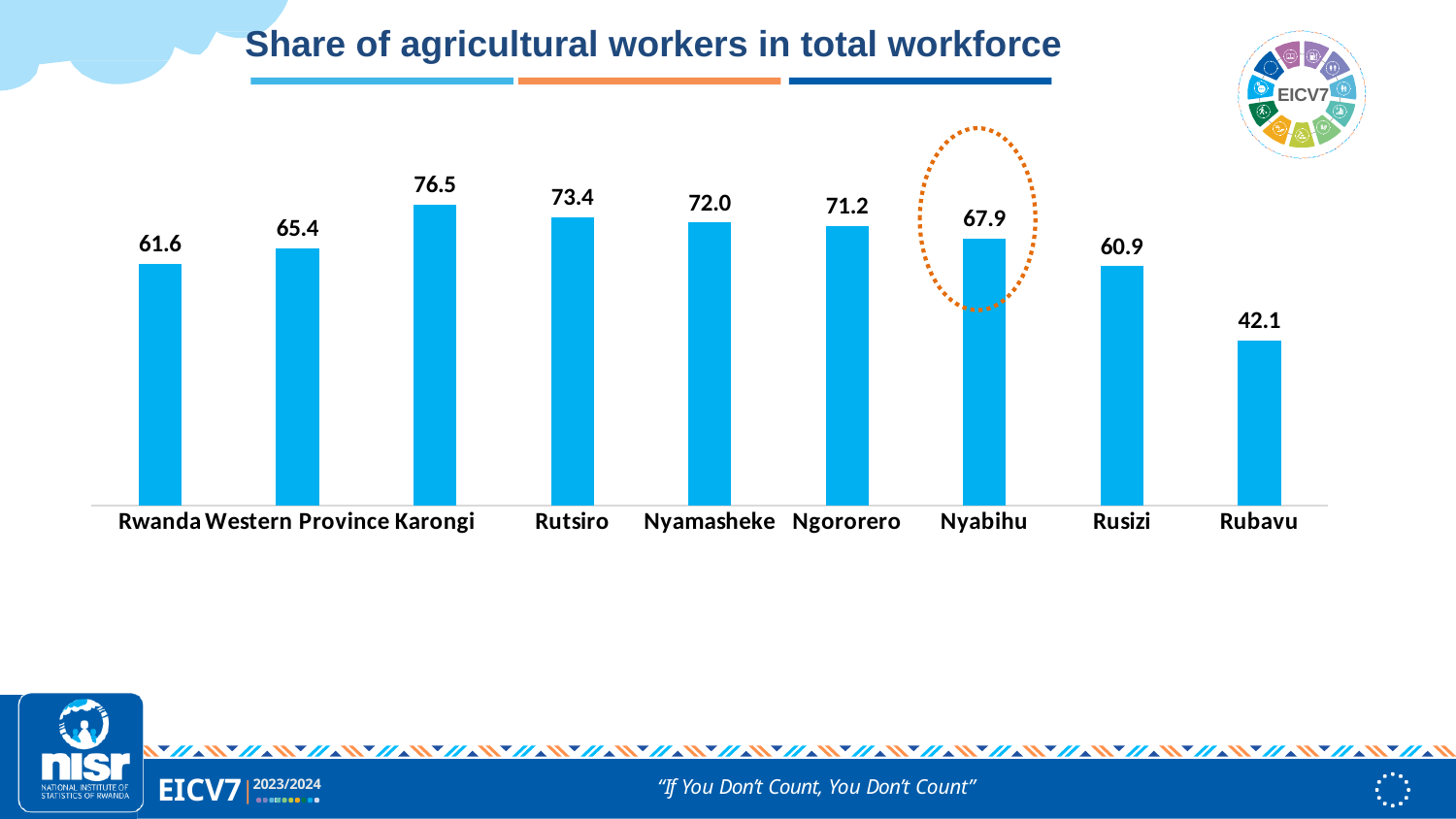
What is the difference between the values for Karongi and Rubavu? 34.4 Which category has the highest share of agricultural workers? Karongi Which bar is highlighted with a dotted orange circle? Nyabihu What is the value shown for Rwanda? 61.6 How many categories are shown on the chart? 9 What is the value shown for Nyabihu? 67.9 Which category has the lowest share of agricultural workers? Rubavu What kind of chart is shown on the slide? Bar chart What is the difference between the values for Western Province and Rwanda? 3.8 What is the share of agricultural workers in total workforce for Karongi? 76.5 Which has a larger value, Rutsiro or Nyamasheke? Rutsiro What is the value shown for Rubavu? 42.1